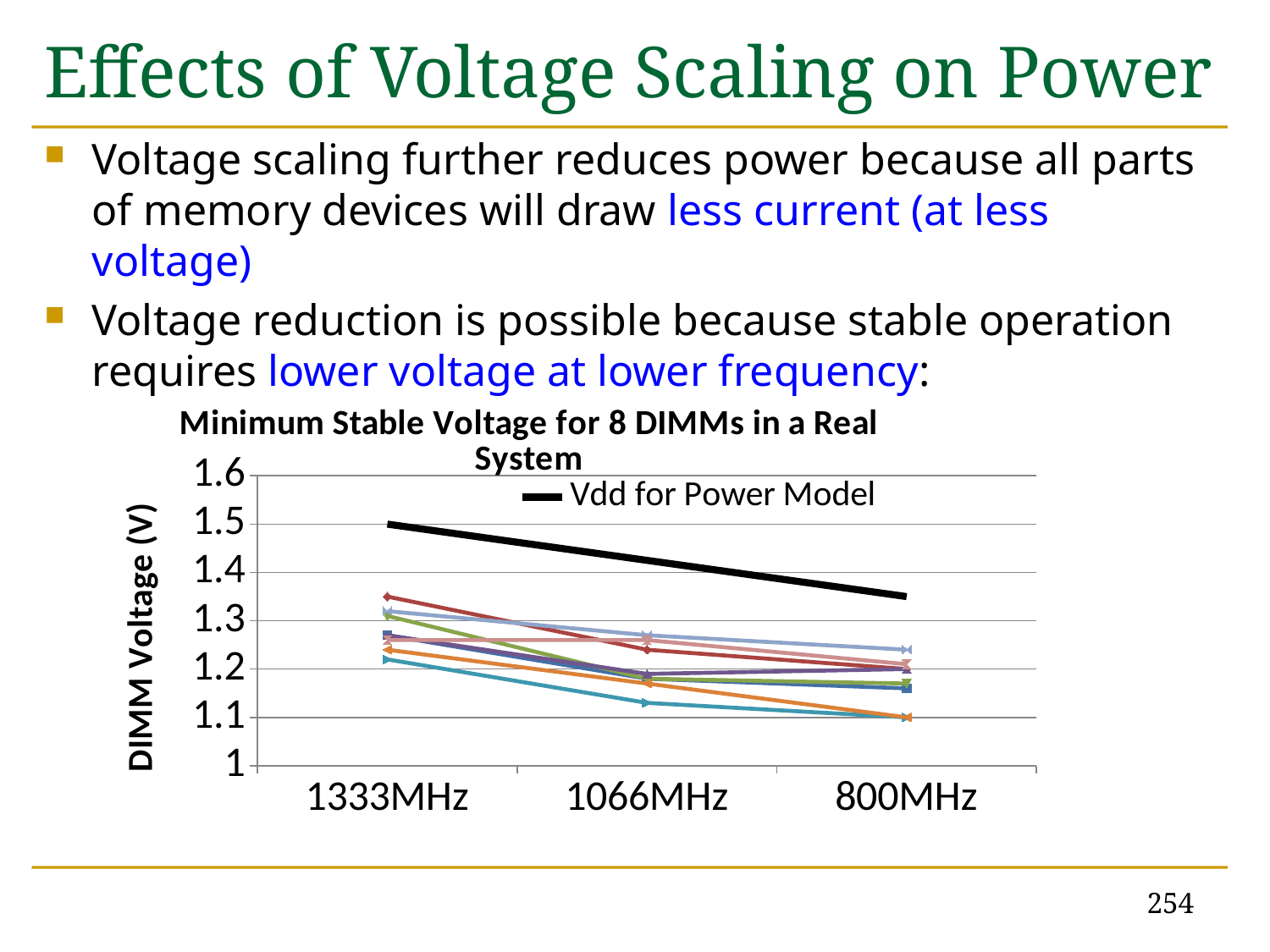
Is the value of Vdd for Power Model at 1333MHz greater or less than 1.4? greater What is the label of the y-axis of the chart? DIMM Voltage (V) What is the value of Vdd for Power Model at 1333MHz? 1.5 Is the value of Vdd for Power Model at 800MHz greater or less than 1.4? less At which frequency is Vdd for Power Model lowest? 800MHz Does the Vdd for Power Model line rise or fall as frequency goes from 1333MHz to 800MHz? fall At which frequency is Vdd for Power Model highest? 1333MHz How many frequency categories are shown on the x-axis? 3 What is the title of the chart? Minimum Stable Voltage for 8 DIMMs in a Real System Which is larger for Vdd for Power Model: the value at 1333MHz or at 800MHz? 1333MHz What kind of chart is shown on the slide? line chart How many series does the chart's legend list? 1